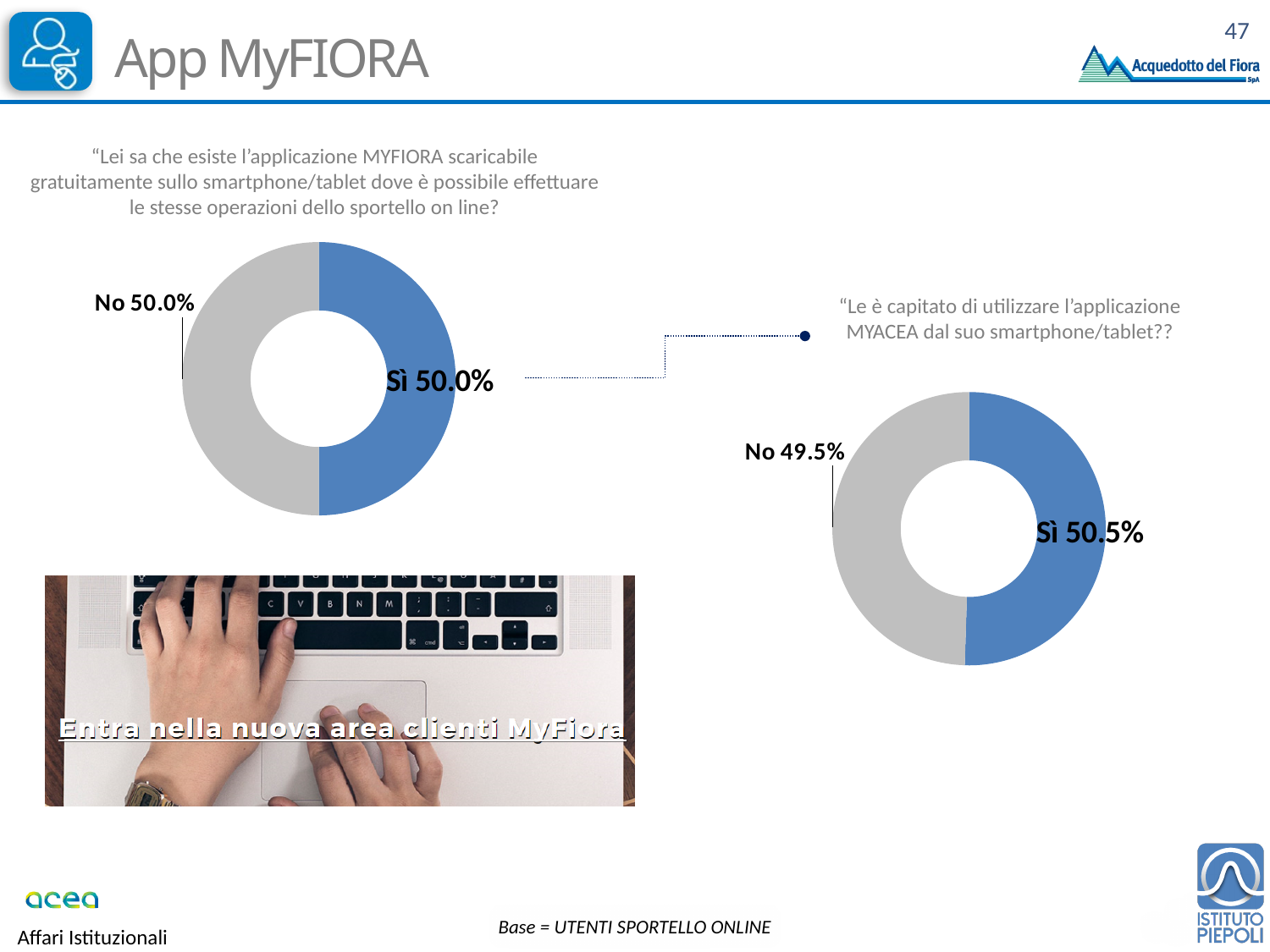
In the right chart, what share of the donut does the "No" slice represent? 49.5% In the left chart about awareness of the MYFIORA app, what percentage answered "No"? 50.0% In the left chart, what colour is the "Sì" slice? Blue In the right chart about having used the app from a smartphone/tablet, what percentage answered "Sì"? 50.5% In the right chart, which answer has the larger share, "Sì" or "No"? Sì How many slices does the right chart have? 2 In the right chart, which answer has the smallest share? No What kind of chart is the left chart? Donut (pie) chart In the left chart about awareness of the MYFIORA app, what percentage answered "Sì"? 50.0% In the right chart about having used the app from a smartphone/tablet, what percentage answered "No"? 49.5% In the right chart, what is the difference between the "Sì" and "No" percentages? 1.0% How many slices does the left chart have? 2